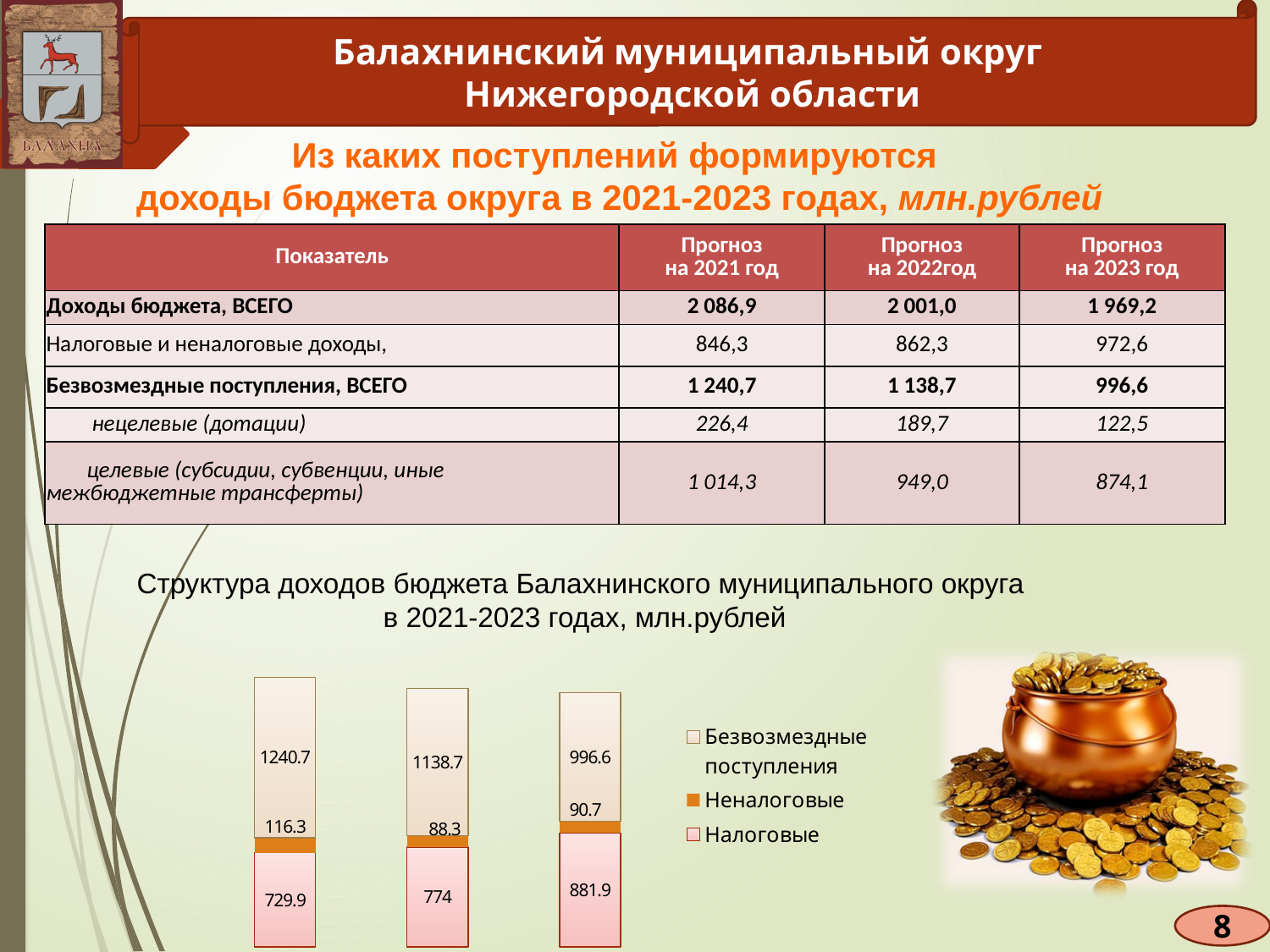
In the stacked bar chart, do the 'Налоговые' values rise or fall from the leftmost bar to the rightmost bar? Rise In the stacked bar chart, which bar has the highest 'Налоговые' value? The rightmost bar (881.9) In the stacked bar chart, which bar has the lowest 'Безвозмездные поступления' value? The rightmost bar (996.6) In the stacked bar chart, what is the value of 'Неналоговые' in the middle bar? 88.3 How many series does the legend of the stacked bar chart list? 3 How many stacked bars are plotted in the chart? 3 In the stacked bar chart, is the 'Неналоговые' value larger in the middle bar or in the rightmost bar? The rightmost bar (90.7) In the stacked bar chart, what is the value of 'Безвозмездные поступления' in the leftmost bar? 1240.7 In the stacked bar chart, what is the difference between the 'Безвозмездные поступления' values of the leftmost and rightmost bars? 244.1 In the stacked bar chart, what is the total of the leftmost stacked bar? 2086.9 What kind of chart is shown at the bottom of the slide under the heading 'Структура доходов бюджета Балахнинского муниципального округа'? Stacked bar chart In the stacked bar chart, what is the value of 'Налоговые' in the rightmost bar? 881.9